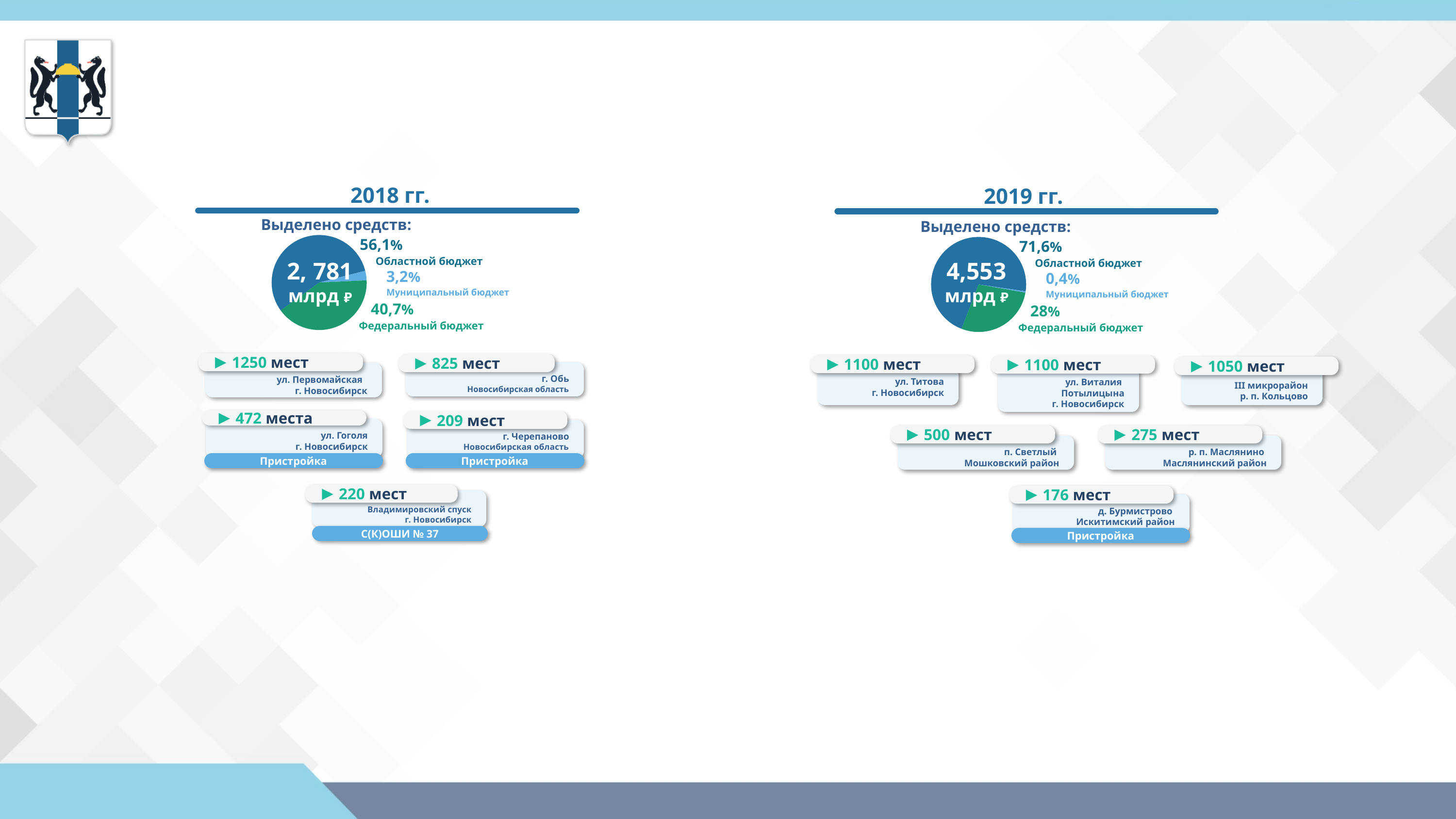
What total amount is printed in the centre of the 2019 pie chart? 4,553 млрд ₽ In the 2018 pie chart, what is the difference in percentage points between Областной бюджет and Федеральный бюджет? 15,4 Which is larger in the 2019 pie chart: the share for Областной бюджет or the share for Федеральный бюджет? Областной бюджет How many slices does the 2018 pie chart have? 3 In the 2019 pie chart, which budget source has the smallest share? Муниципальный бюджет In the 2018 pie chart, which budget source has the largest share? Областной бюджет In the 2019 pie chart, what is the difference in percentage points between Областной бюджет and Федеральный бюджет? 43,6 What kind of chart is used under the 2019 гг. heading to show the allocated funds? Pie chart In the 2018 pie chart, what share is labelled for Муниципальный бюджет? 3,2% In the 2019 pie chart, what share is labelled for Федеральный бюджет? 28% In the 2019 pie chart, what share is labelled for Муниципальный бюджет? 0,4% In the 2018 pie chart, what share is labelled for Областной бюджет? 56,1%